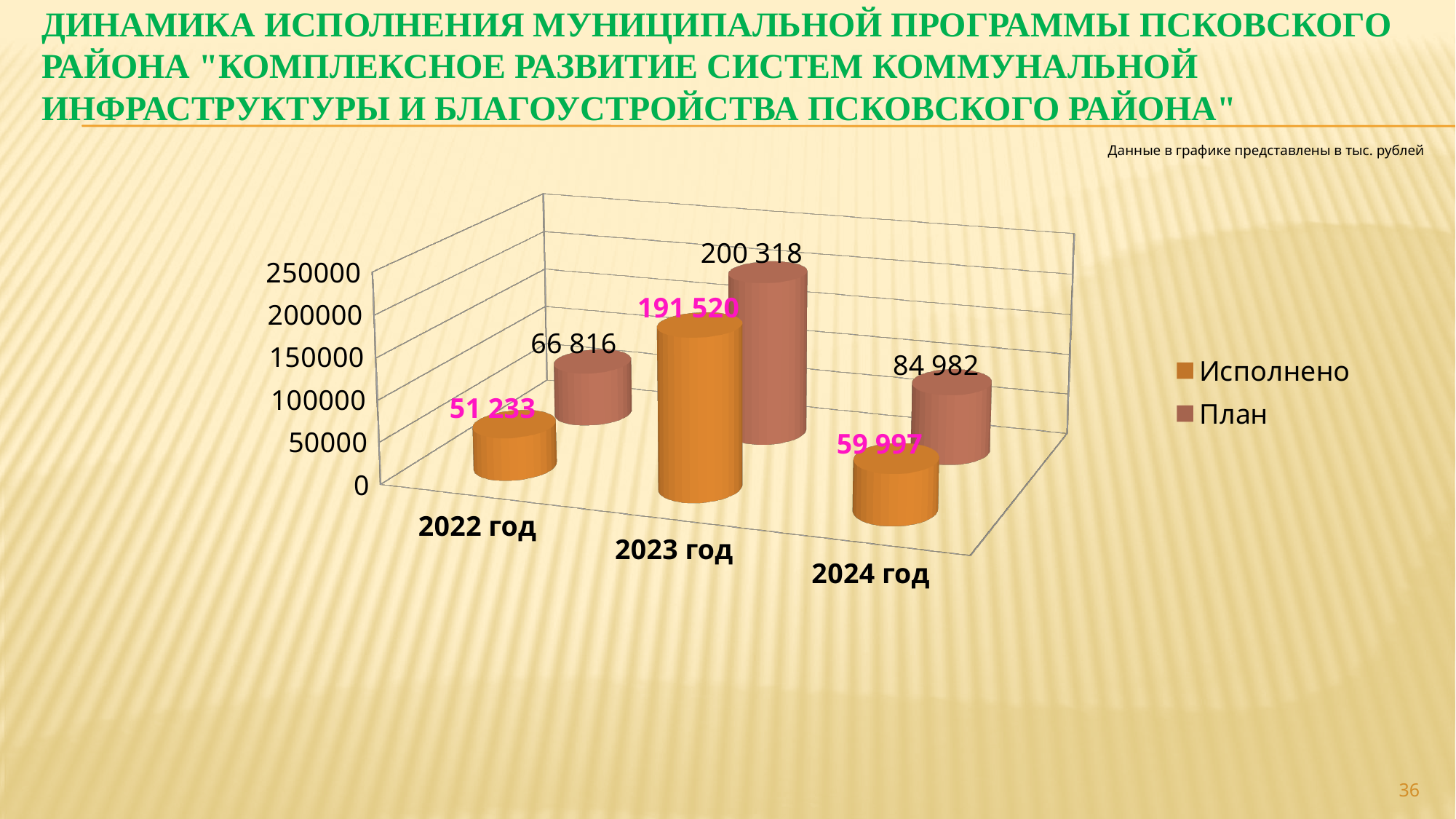
What kind of chart is shown on the slide? Bar chart Which is larger for 2023 год: Исполнено or План? План What is the value of Исполнено for 2022 год? 51 233 What is the difference between План and Исполнено for 2024 год? 24 985 What is the value of Исполнено for 2024 год? 59 997 How many years are shown on the x axis of the chart? 3 How many series does the legend list? 2 In which year is the План value lowest? 2022 год What is the value of План for 2023 год? 200 318 What is the value of План for 2024 год? 84 982 What is the difference between План and Исполнено for 2022 год? 15 583 In which year is the Исполнено value highest? 2023 год